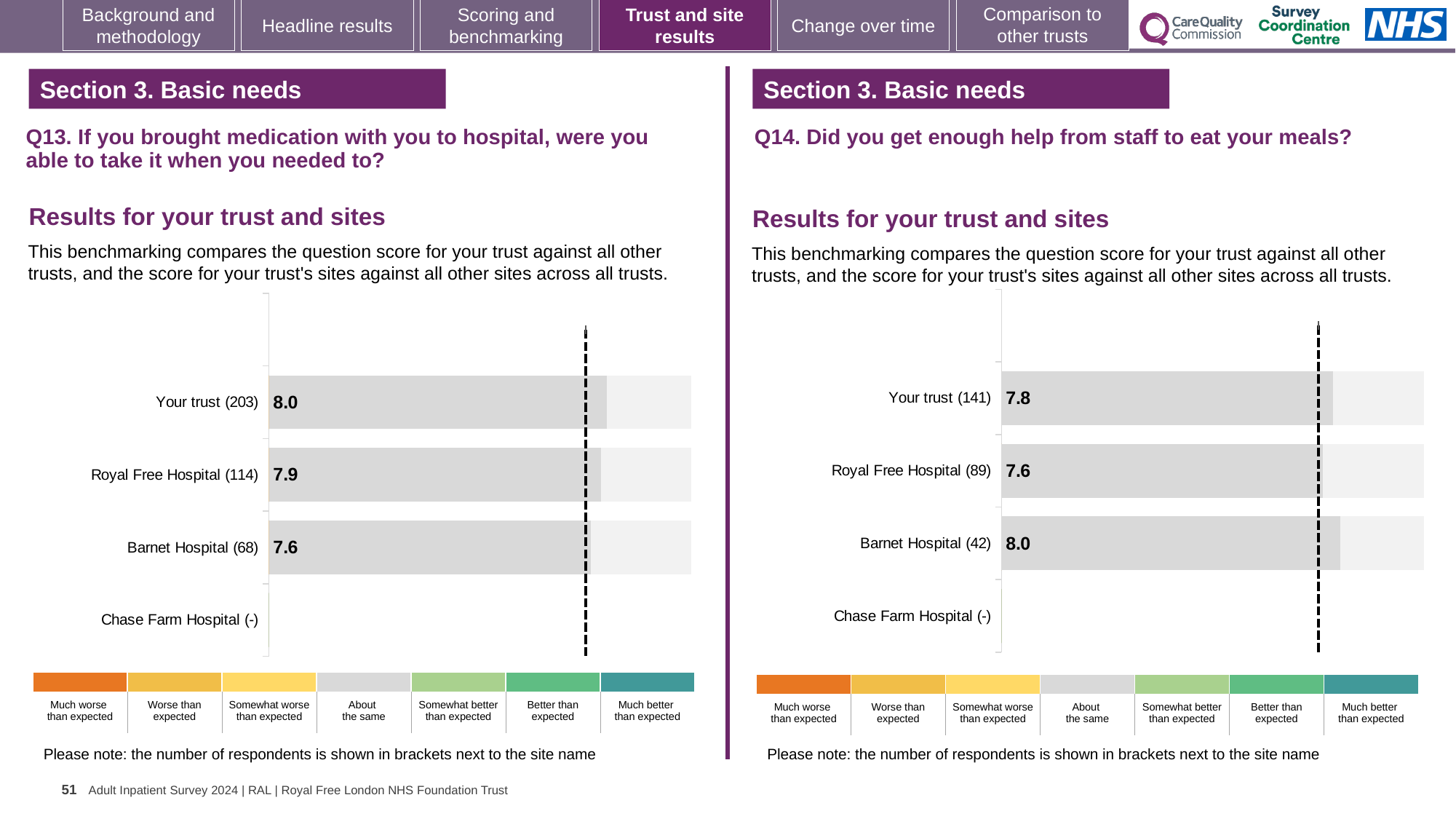
In the Q13 chart on the left, what is the score for Barnet Hospital? 7.6 In the Q13 chart on the left, what is the score for Your trust? 8.0 In the Q13 chart on the left, what is the difference between the scores for Your trust and Barnet Hospital? 0.4 In the Q13 chart on the left, how many respondents are shown for Royal Free Hospital? 114 In the Q14 chart on the right, which is larger, the score for Your trust or the score for Royal Free Hospital? Your trust In the Q14 chart on the right, which site has the highest score? Barnet Hospital In the Q14 chart on the right, what is the difference between the scores for Barnet Hospital and Royal Free Hospital? 0.4 In the Q14 chart on the right, what is the score for Royal Free Hospital? 7.6 How many rows (sites including Your trust) are listed in the Q13 chart on the left? 4 In the Q13 chart on the left, which site with a score has the lowest score? Barnet Hospital In the Q14 chart on the right, how many respondents are shown for Your trust? 141 What kind of chart is used in the Q14 chart on the right? Bar chart